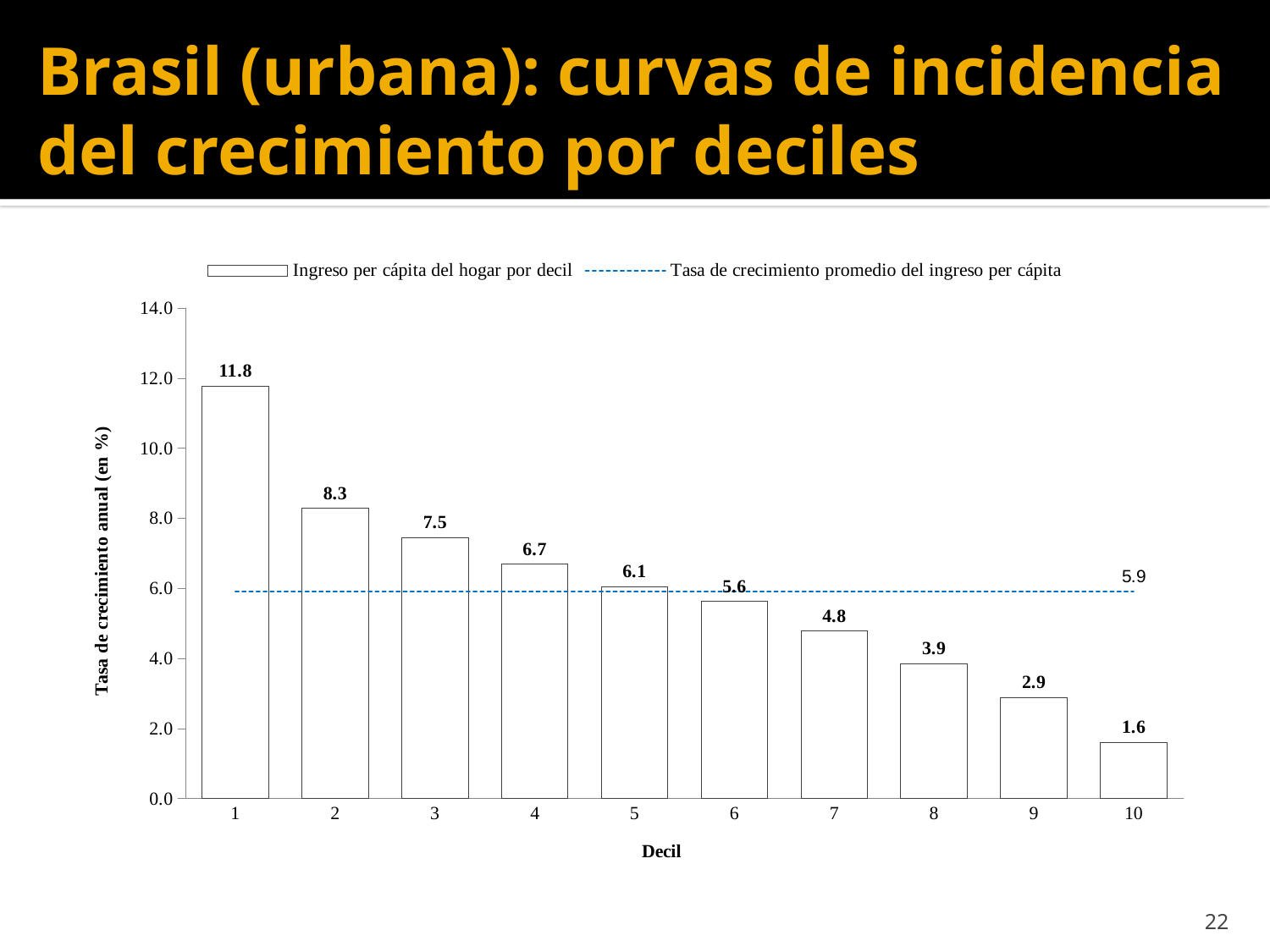
Is the value for decile 2 greater or less than 8.0? greater What kind of chart is shown on the slide? Combination bar and line chart What value does the dashed line for the average growth rate of per capita income show? 5.9 What is the annual growth rate for decile 7? 4.8 Which decile has the lowest annual growth rate? 10 What is the annual growth rate for decile 1? 11.8 How many series does the legend list? 2 How many deciles are shown on the x axis? 10 Which decile has the highest annual growth rate? 1 What is the difference between the growth rates of decile 1 and decile 10? 10.2 Which has a higher growth rate, decile 3 or decile 8? Decile 3 Do the growth rates rise or fall as the decile number increases? Fall